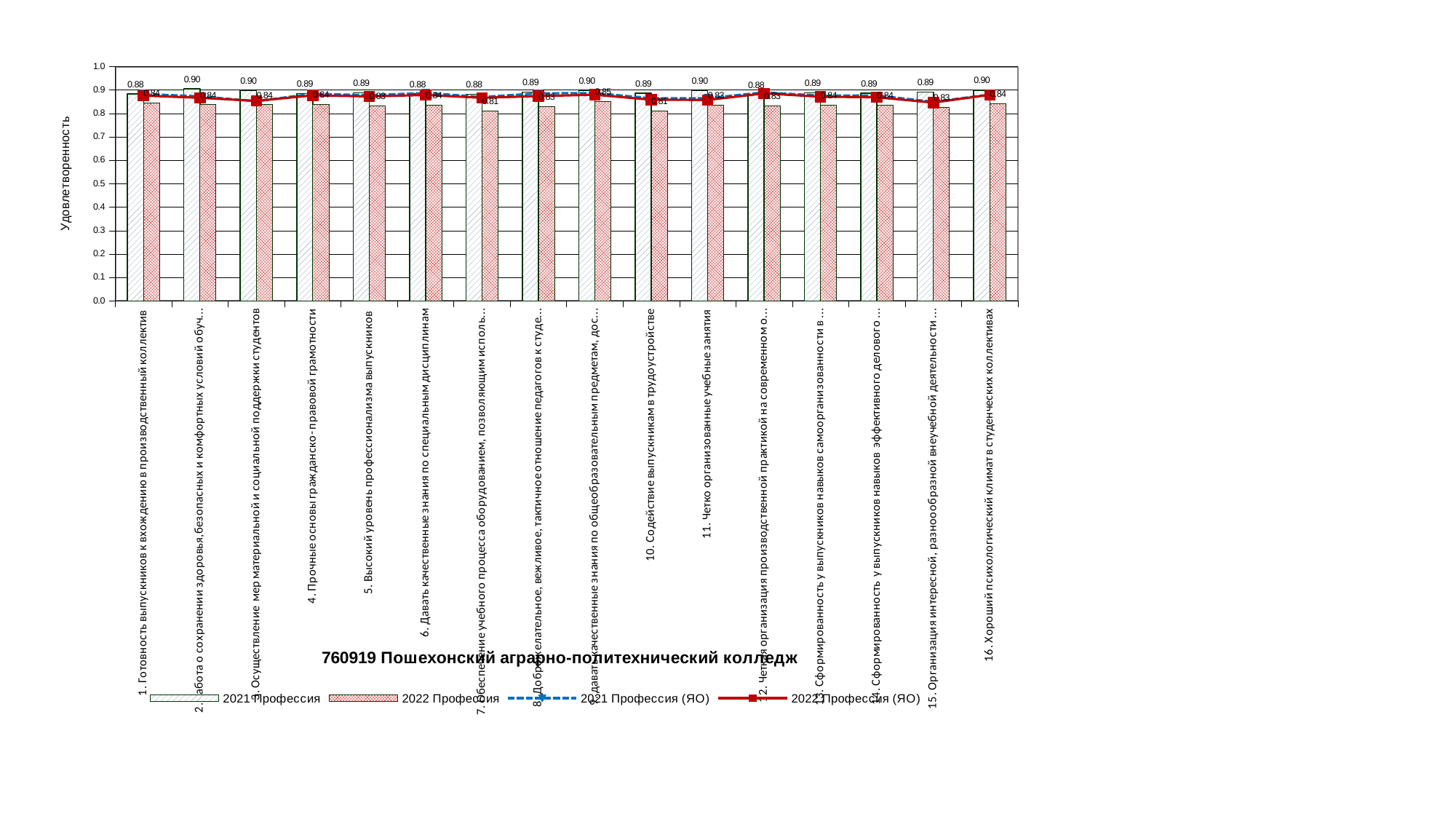
How many series does the legend list? 4 What is the 2021 Профессия value for '10. Содействие выпускникам в трудоустройстве'? 0.89 Which has the larger 2021 Профессия value: '11. Четко организованные учебные занятия' or '1. Готовность выпускников к вхождению в производственный коллектив'? 11. Четко организованные учебные занятия How many categories are shown along the x axis? 16 What is the difference between the 2021 Профессия values for '16. Хороший психологический климат в студенческих коллективах' and '1. Готовность выпускников к вхождению в производственный коллектив'? 0.02 What is the title of the y axis? Удовлетворенность What kind of chart is shown on the slide? bar chart with line series What is the 2021 Профессия value for '11. Четко организованные учебные занятия'? 0.90 What is the 2021 Профессия value for '1. Готовность выпускников к вхождению в производственный коллектив'? 0.88 What is the 2022 Профессия value for '10. Содействие выпускникам в трудоустройстве'? 0.81 Is the 2022 Профессия value for '10. Содействие выпускникам в трудоустройстве' greater or less than 0.9? less What is the 2021 Профессия value for '16. Хороший психологический климат в студенческих коллективах'? 0.90